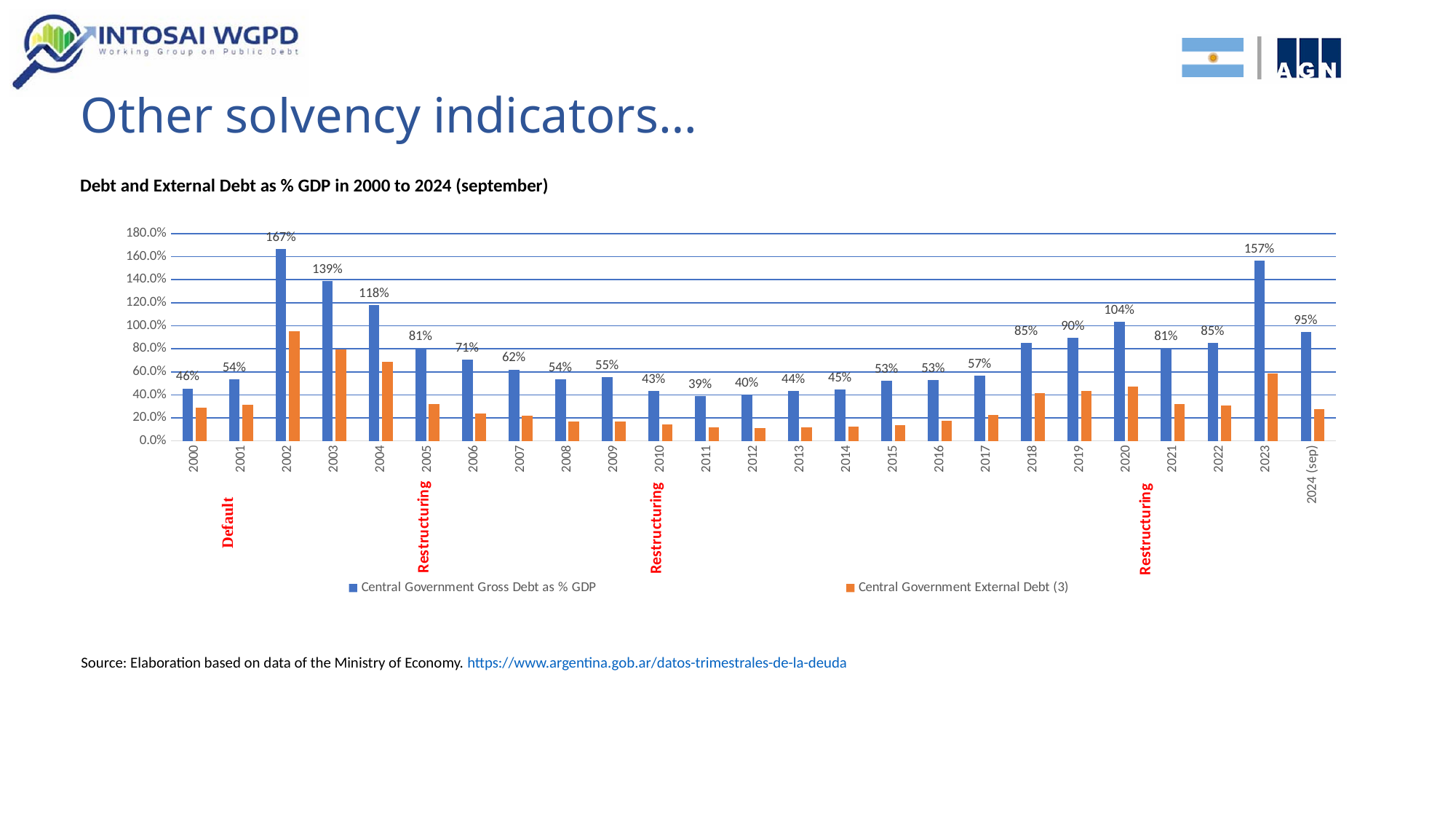
How many years (categories) are shown on the x axis of the chart? 25 How many series does the chart legend list? 2 Is the value for Central Government External Debt (3) in 2011 greater or less than 20.0%? less What is the Central Government Gross Debt as % GDP for 2002? 167% Is the value for Central Government External Debt (3) in 2002 greater or less than 80.0%? greater Which year has a higher Central Government Gross Debt as % GDP, 2019 or 2020? 2020 What type of chart is shown on the slide? Bar chart Which year has the highest Central Government Gross Debt as % GDP? 2002 Which year has the lowest Central Government Gross Debt as % GDP? 2011 What is the Central Government Gross Debt as % GDP for 2023? 157% What is the difference between the Central Government Gross Debt as % GDP in 2002 and in 2023? 10% What is the Central Government Gross Debt as % GDP for 2024 (sep)? 95%